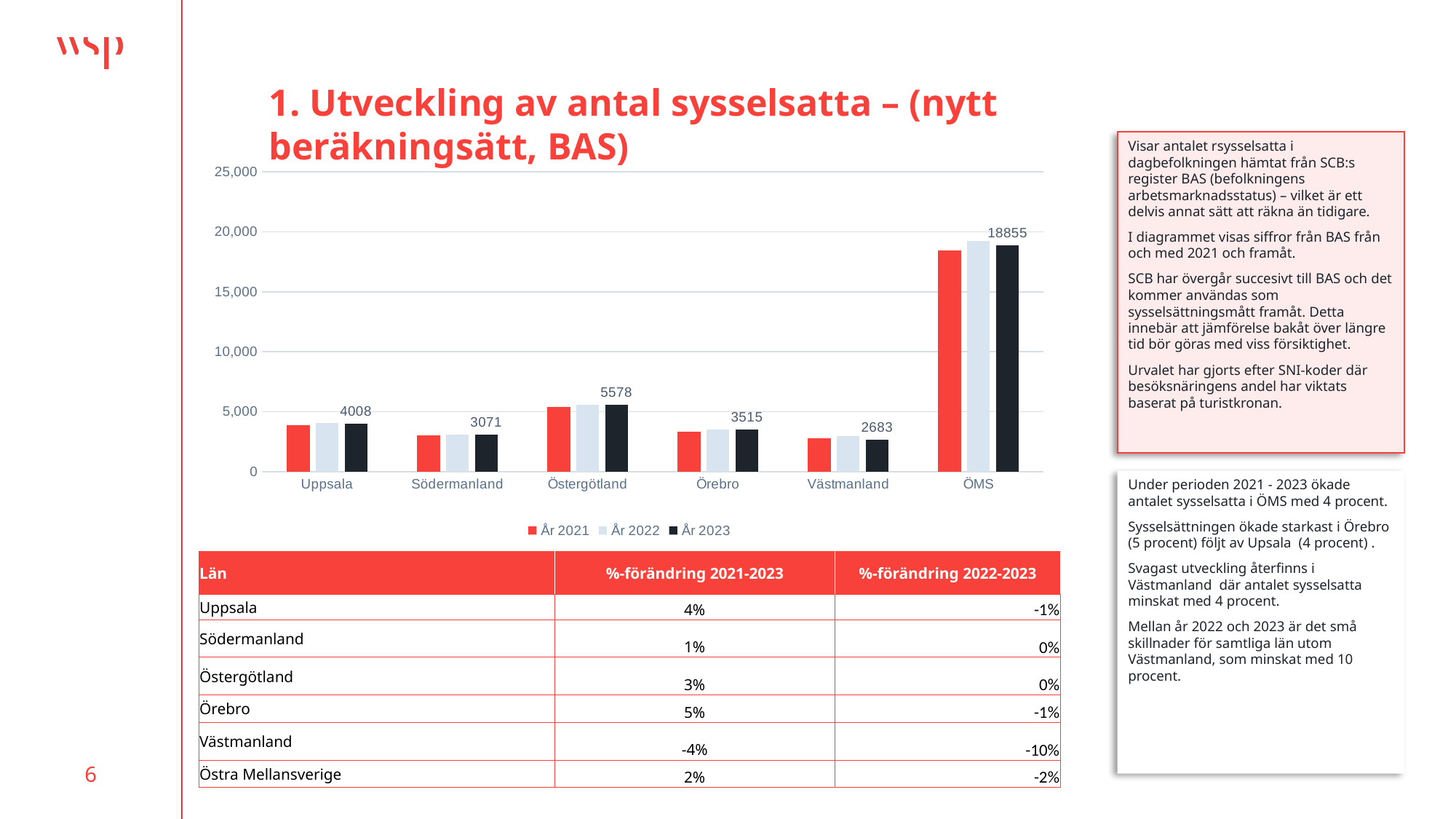
What kind of chart is shown on the slide? Bar chart How many categories are shown on the x axis of the chart? 6 What is the difference between the År 2023 values for Östergötland and Södermanland? 2507 Which category has the highest value in the År 2023 series? ÖMS What is the value for Västmanland in the År 2023 series? 2683 In the År 2023 series, which is larger: Örebro or Södermanland? Örebro Which category has the lowest value in the År 2023 series? Västmanland How many series does the chart legend list? 3 What is the value for ÖMS in the År 2023 series? 18855 Is the År 2021 value for ÖMS greater or less than 15,000? greater What is the value for Östergötland in the År 2023 series? 5578 What is the value for Uppsala in the År 2023 series? 4008